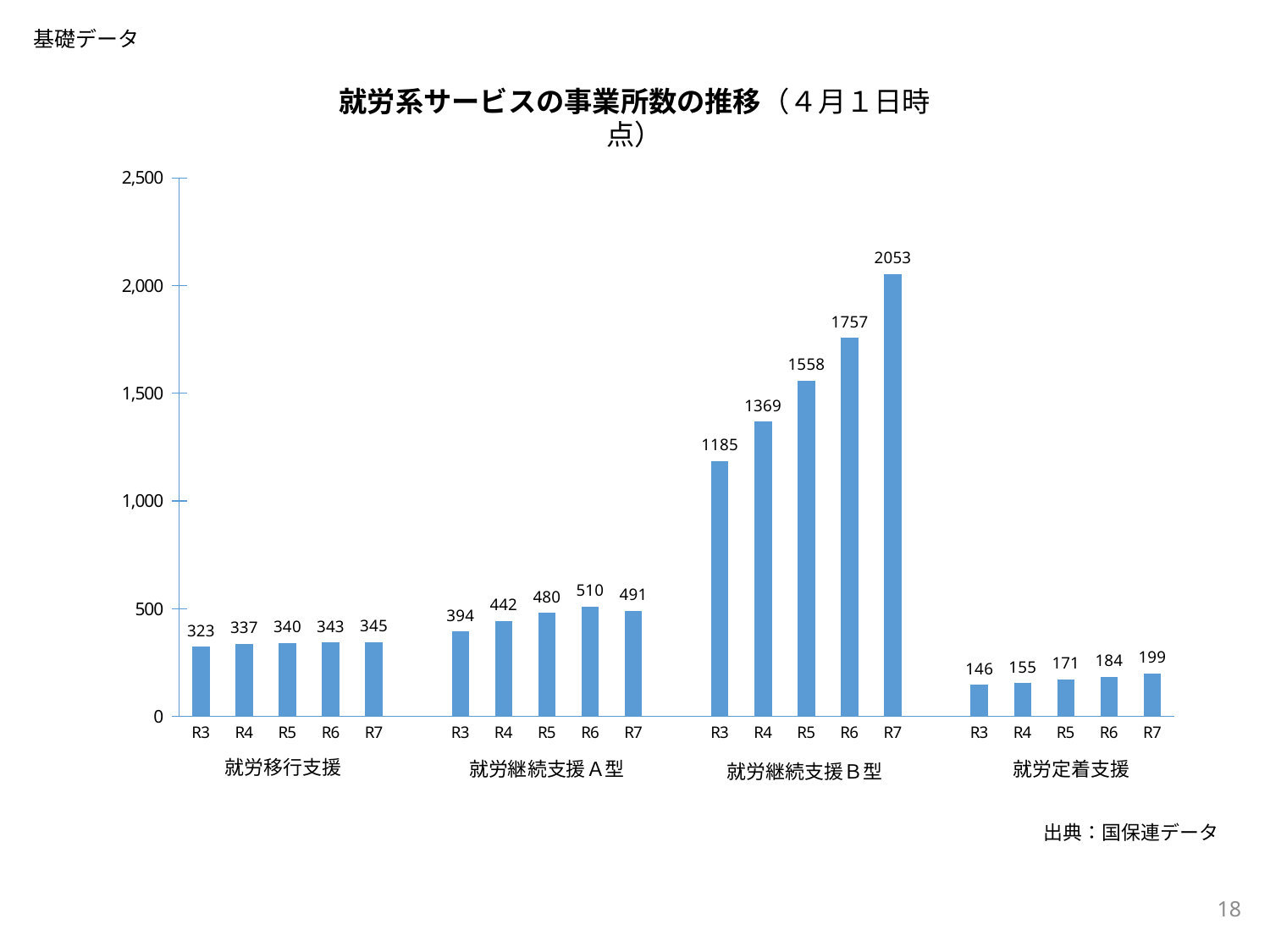
What is the value for R3 in the 就労移行支援 group? 323 What is the difference between the R7 and R3 values in the 就労継続支援Ｂ型 group? 868 What is the value for R6 in the 就労継続支援Ａ型 group? 510 Which bar has the highest value on the chart? 就労継続支援Ｂ型 R7 Which bar has the lowest value on the chart? 就労定着支援 R3 Which is larger: the R7 value for 就労継続支援Ａ型 or the R6 value for 就労継続支援Ａ型? R6 (510) Do the values in the 就労定着支援 group rise or fall from R3 to R7? rise What is the value for R5 in the 就労定着支援 group? 171 How many bars are plotted on the chart in total? 20 Is the R5 value for 就労継続支援Ｂ型 greater or less than 1,500? greater What type of chart is shown on the slide? bar chart What is the value for R7 in the 就労継続支援Ｂ型 group? 2053